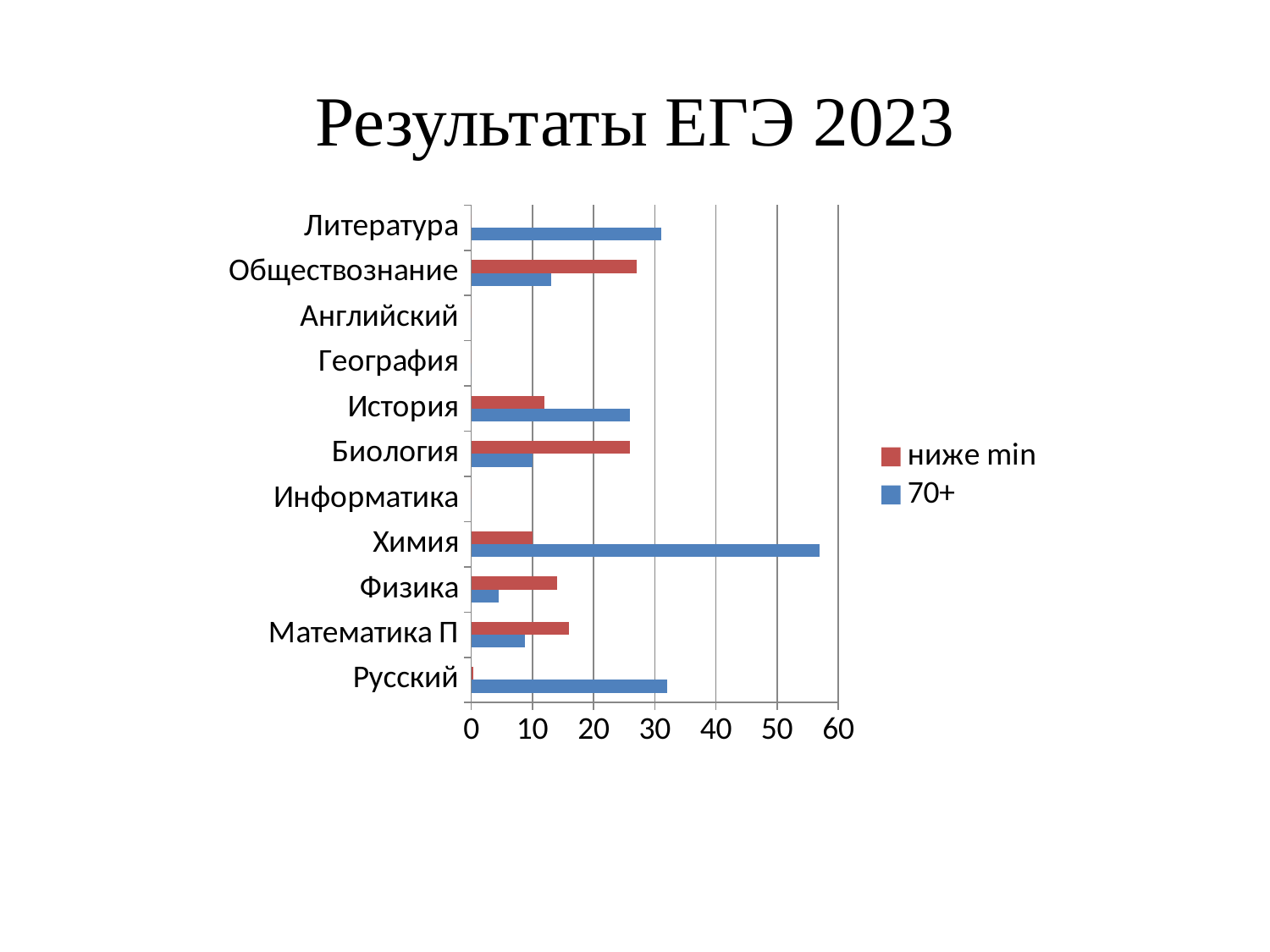
How many series does the legend list? 2 For История, which series has the larger value: ниже min or 70+? 70+ Is the 70+ value for Физика greater or less than 10? less Is the 70+ value for Литература greater or less than 20? greater Which subject has the highest value for the 70+ series? Химия For Биология, which series has the larger value: ниже min or 70+? ниже min Is the ниже min value for Обществознание greater or less than 20? greater How many subject categories are shown on the vertical axis? 11 For Физика, which series has the larger value: ниже min or 70+? ниже min What is the title of the slide? Результаты ЕГЭ 2023 What kind of chart is shown on the slide? bar chart